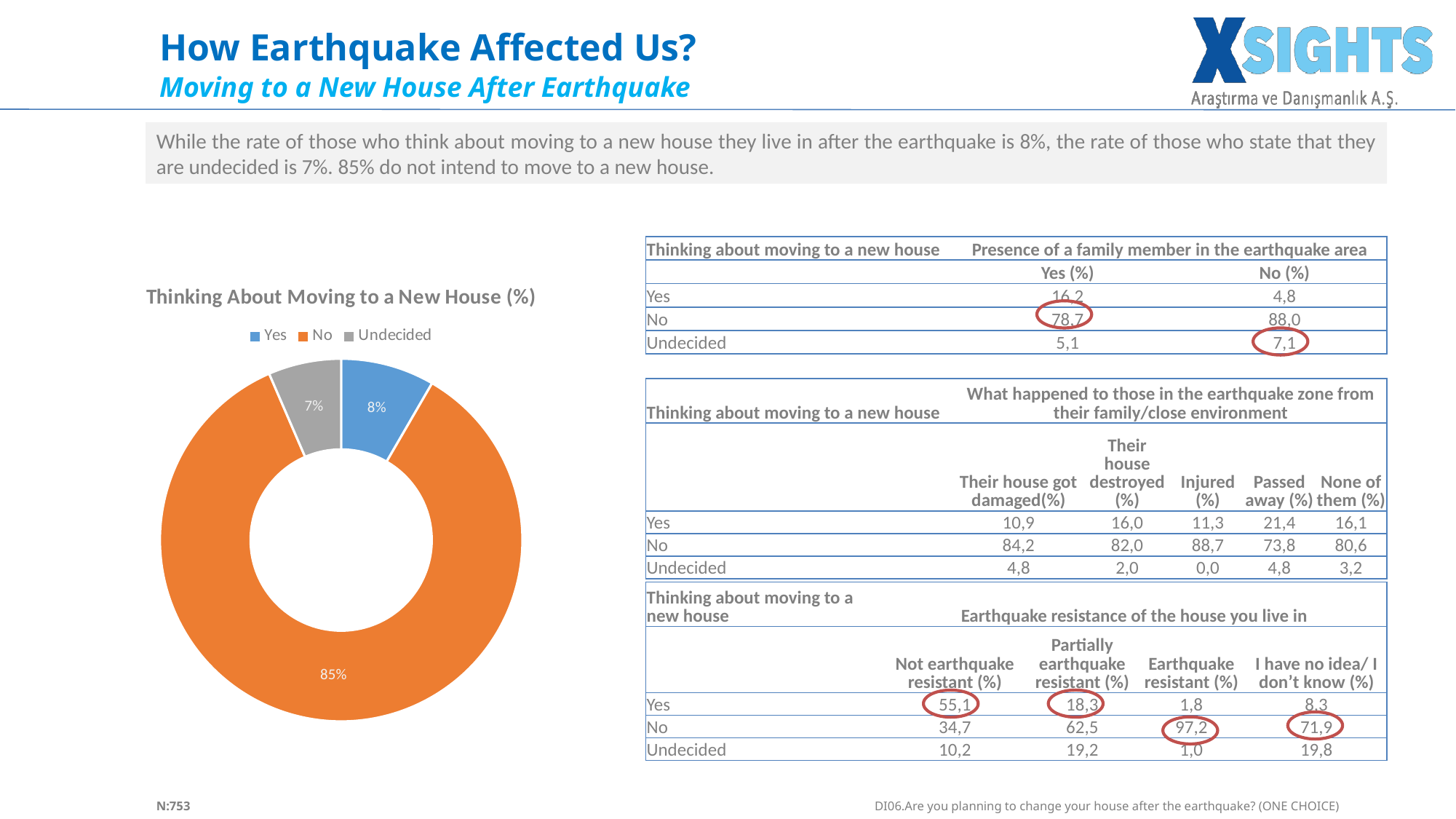
What is the title of the chart on the slide? Thinking About Moving to a New House (%) What is the value for Yes in the Thinking About Moving to a New House (%) chart? 8% What is the difference between the No and Yes shares in the Thinking About Moving to a New House (%) chart? 77% What colour represents No in the Thinking About Moving to a New House (%) chart? Orange How many entries does the legend of the Thinking About Moving to a New House (%) chart list? 3 Which category has the largest share in the Thinking About Moving to a New House (%) chart? No Which is larger in the Thinking About Moving to a New House (%) chart, Yes or Undecided? Yes What is the value for Undecided in the Thinking About Moving to a New House (%) chart? 7% Which category has the smallest share in the Thinking About Moving to a New House (%) chart? Undecided What is the value for No in the Thinking About Moving to a New House (%) chart? 85% How many categories are shown in the Thinking About Moving to a New House (%) chart? 3 What type of chart is the Thinking About Moving to a New House (%) chart? Doughnut (pie) chart